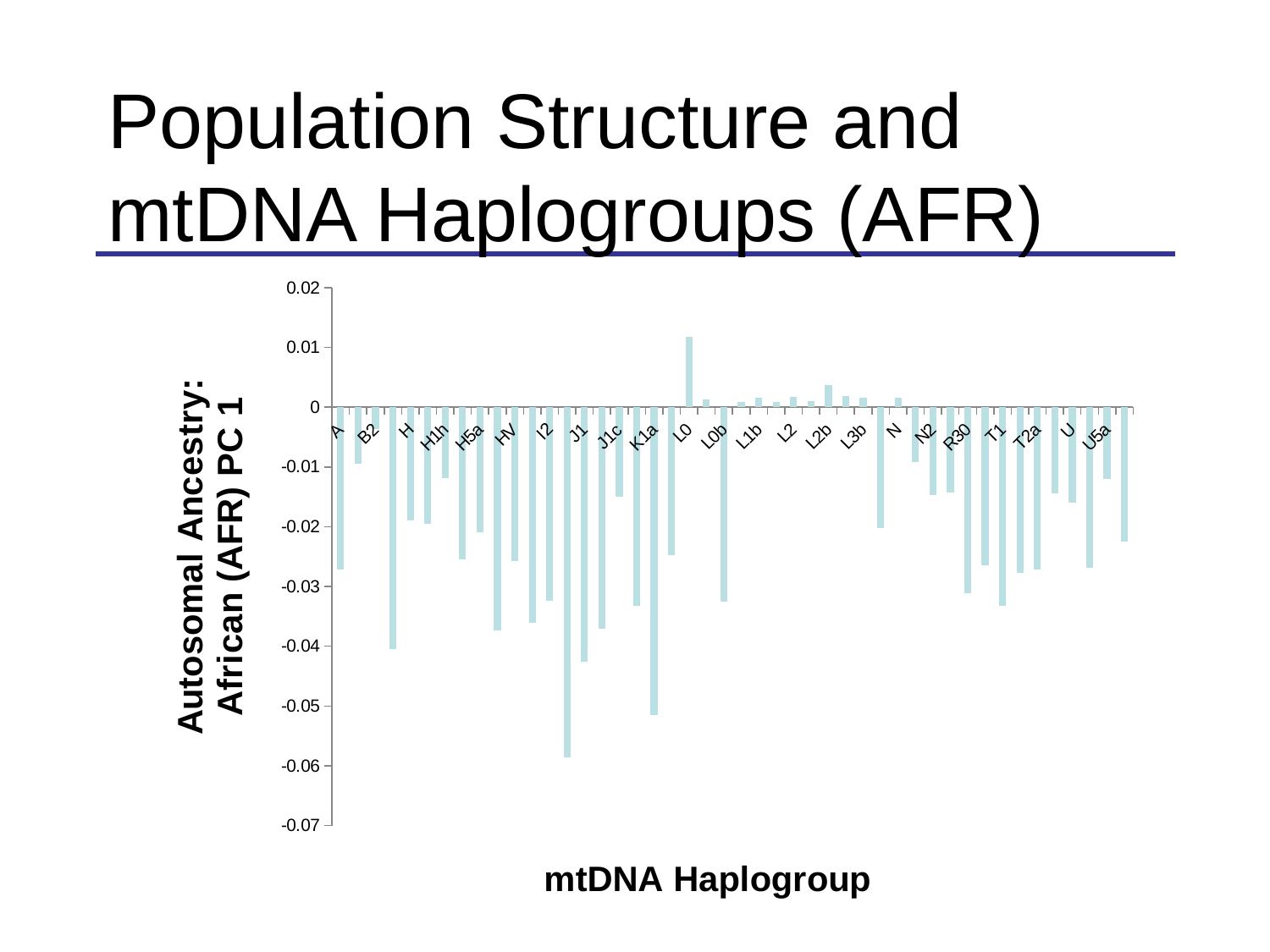
What kind of chart is shown on the slide? bar chart Is the value for L0 greater or less than 0? greater What is the lowest value shown on the y axis? -0.07 Which has the larger value, L0 or A? L0 What is the label of the x axis? mtDNA Haplogroup What is the label of the y axis? Autosomal Ancestry: African (AFR) PC 1 Is the value for A greater or less than -0.02? less What is the highest value shown on the y axis? 0.02 Which mtDNA haplogroup has the highest value of Autosomal Ancestry: African (AFR) PC 1? L0